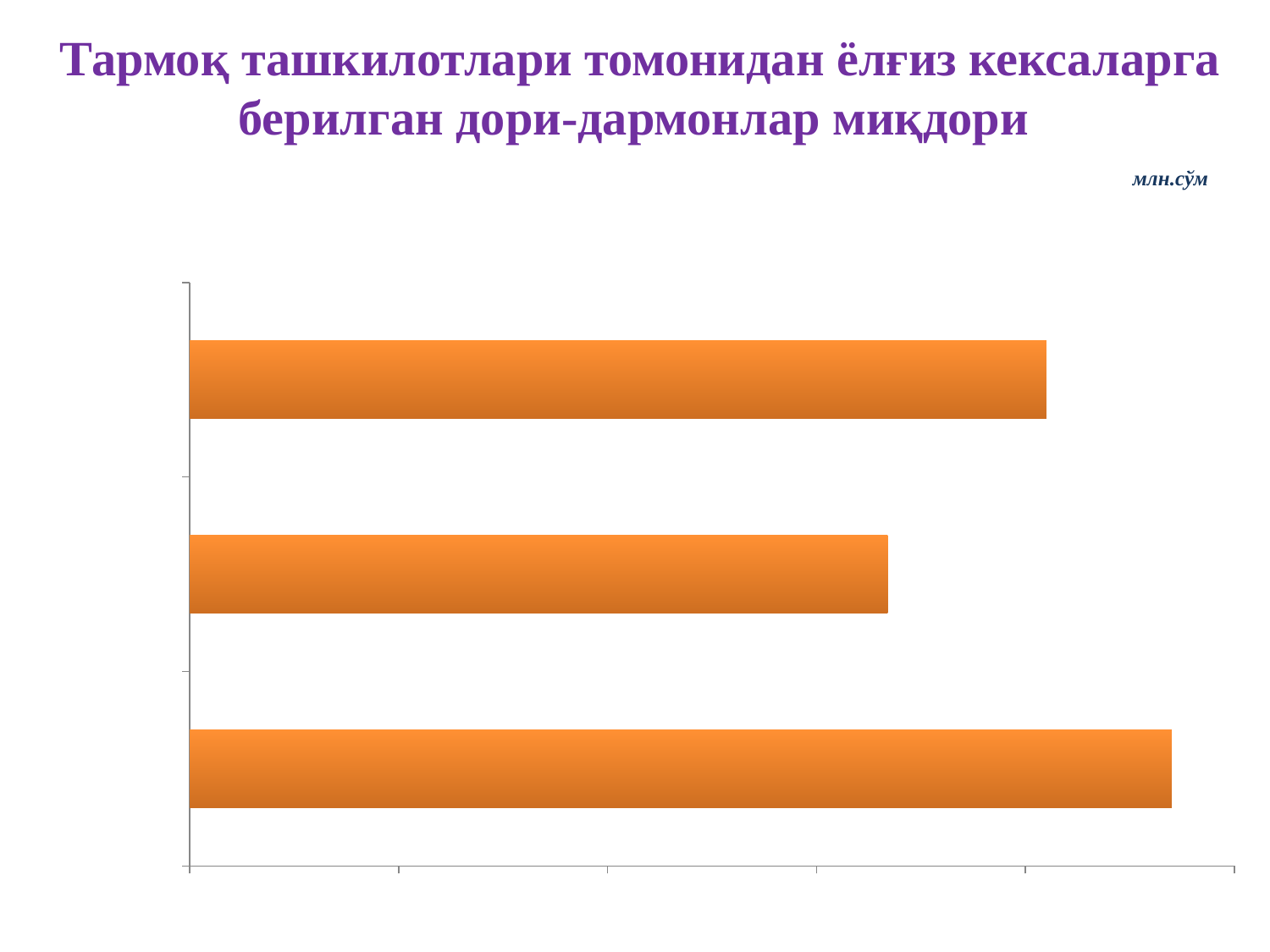
What unit is indicated above the chart? млн.сўм Which bar is the shortest: the top, middle or bottom bar? middle Which bar is the longest: the top, middle or bottom bar? bottom Which is larger, the top bar or the middle bar? top bar Are the bars in the chart oriented horizontally or vertically? horizontally Which is larger, the bottom bar or the top bar? bottom bar How many bars does the chart contain? 3 What kind of chart is shown on the slide? bar chart